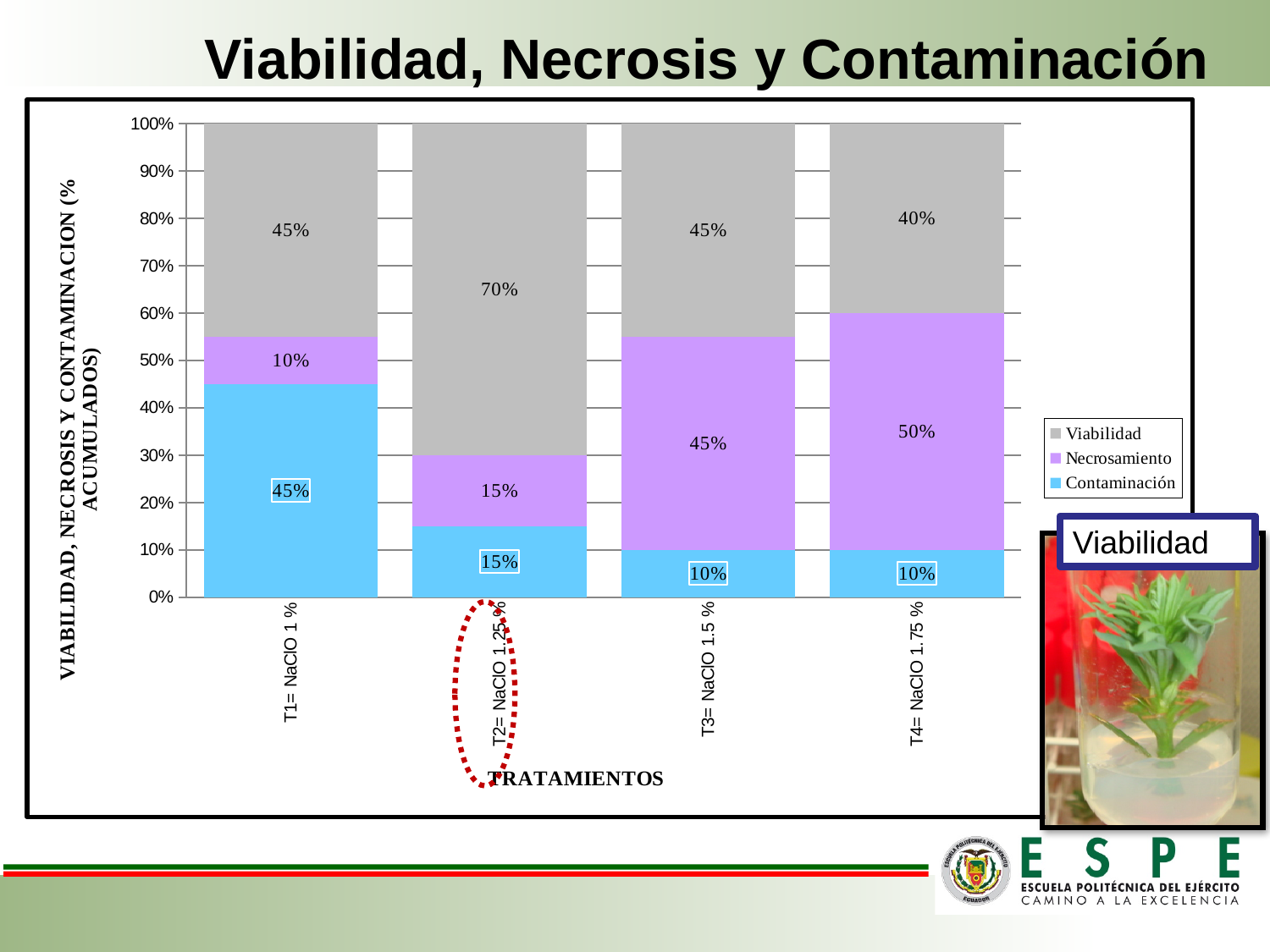
What is the Necrosamiento value for T4= NaClO 1.75 %? 50% What is the Viabilidad value for T2= NaClO 1.25 %? 70% What is the Contaminación value for T3= NaClO 1.5 %? 10% How many treatments are shown on the x axis? 4 Which treatment has the highest Viabilidad value? T2= NaClO 1.25 % What kind of chart is shown on the slide? Stacked bar chart What is the difference between the Viabilidad values for T2= NaClO 1.25 % and T4= NaClO 1.75 %? 30% How many series does the legend list? 3 Which is larger, the Contaminación value for T1= NaClO 1 % or for T2= NaClO 1.25 %? T1= NaClO 1 % Which treatment has the lowest Necrosamiento value? T1= NaClO 1 % What is the Contaminación value for T1= NaClO 1 %? 45% What is the total of the stacked bar for T3= NaClO 1.5 %? 100%